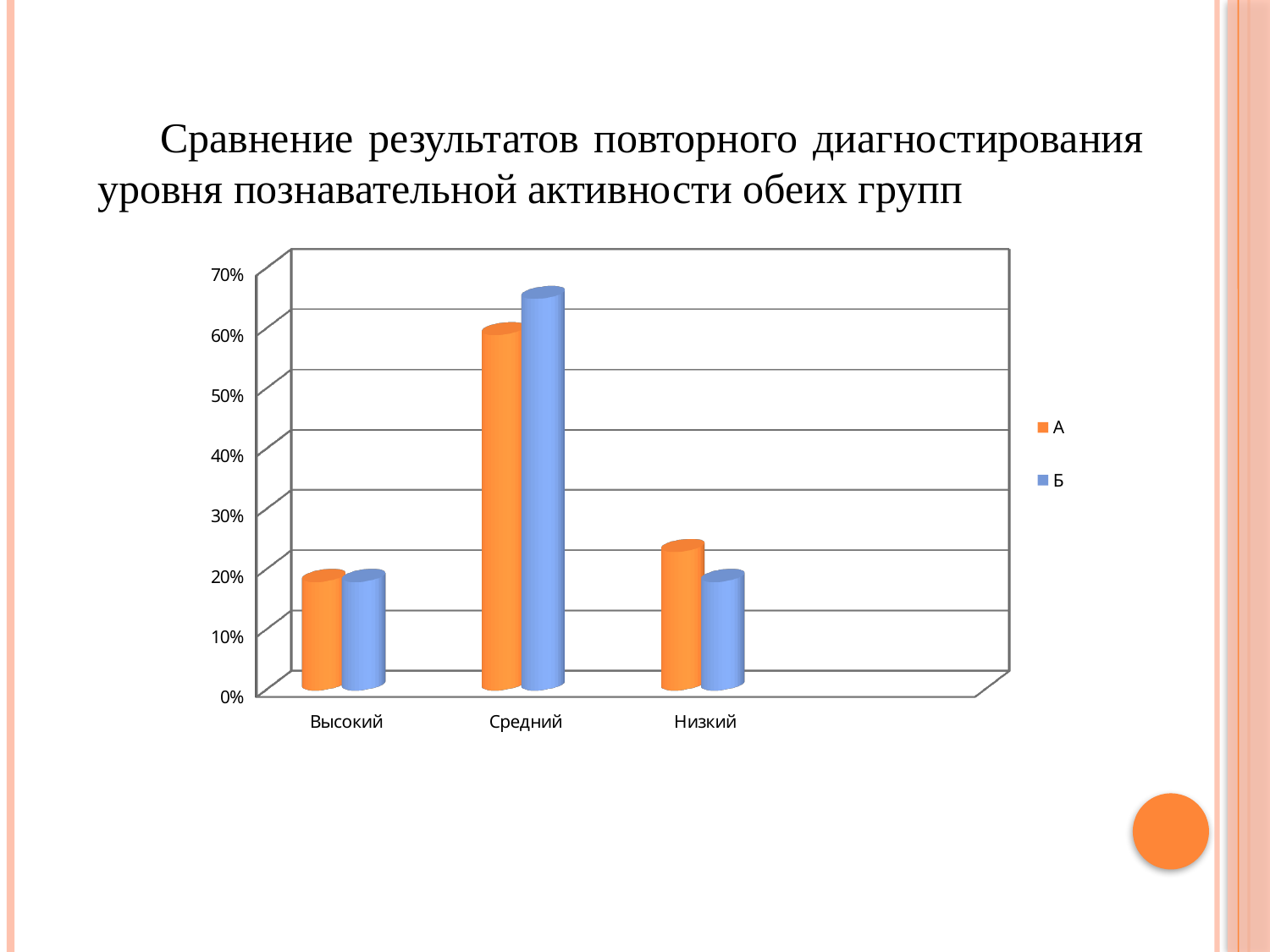
How many categories are shown on the x axis of the chart? 3 For the category Средний, which series has the larger value, А or Б? Б For the category Низкий, which series has the larger value, А or Б? А Is the value for series А in the category Средний greater or less than 50%? greater Is the value for series А in the category Низкий greater or less than 30%? less Is the value for series Б in the category Высокий greater or less than 30%? less Which category has the lowest value for series А? Высокий Which category has the highest value for series А? Средний What colour are the bars for series А in the chart? orange What kind of chart is shown on the slide? bar chart Which category has the highest value for series Б? Средний How many series does the chart's legend list? 2